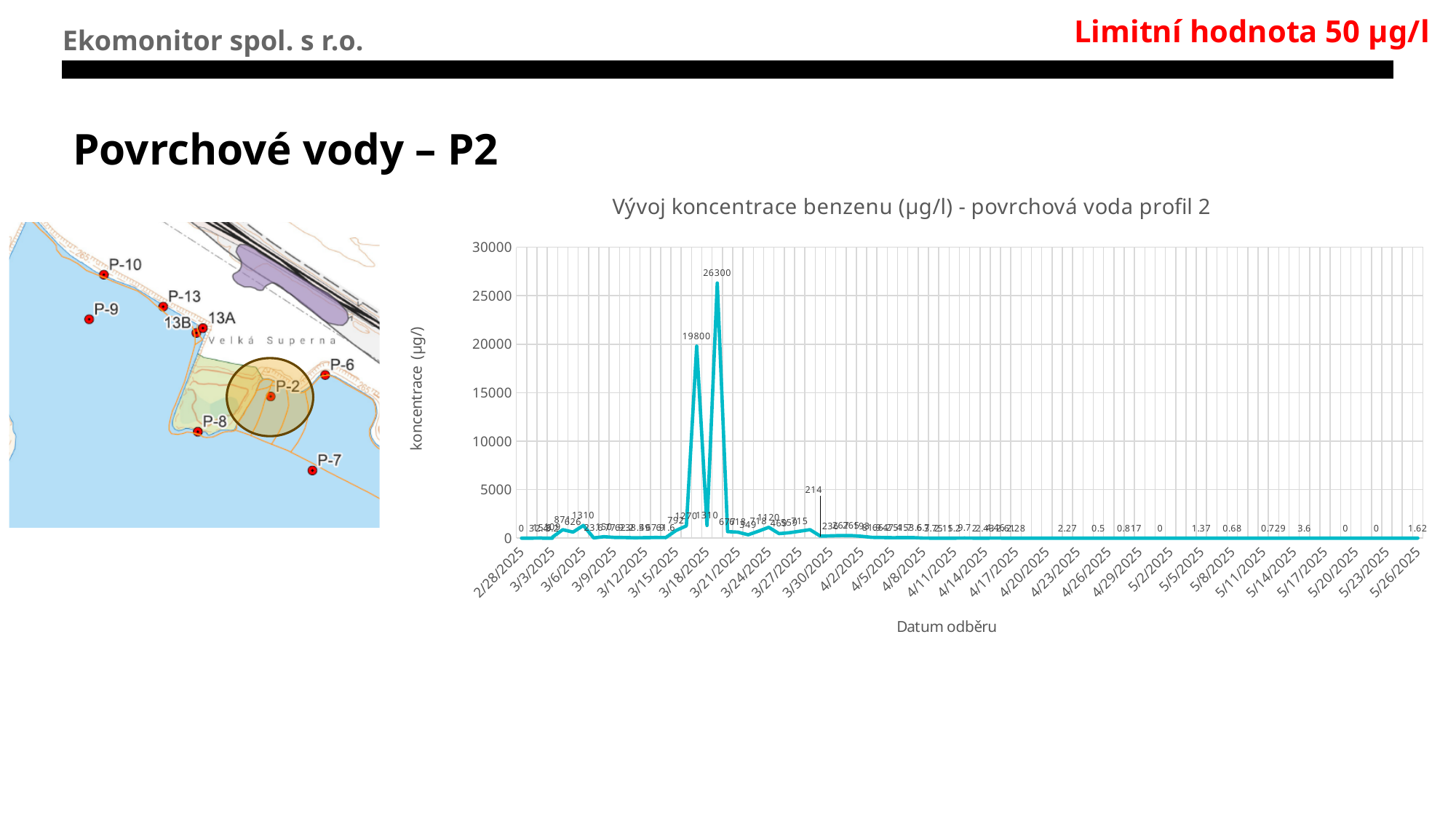
What is the title of the chart? Vývoj koncentrace benzenu (µg/l) - povrchová voda profil 2 What is the difference between the two highest labeled peaks, 26300 and 19800? 6500 Is the value for 5/26/2025 greater or less than 5000? less What is the label of the vertical axis of the chart? koncentrace (µg/l) What is the highest benzene concentration value labeled on the chart? 26300 Is the highest value on the chart greater or less than 25000? greater What is the second-highest peak value labeled on the chart? 19800 Which is larger, the peak labeled 26300 or the peak labeled 19800? 26300 What is the benzene concentration value labeled for the last date, 5/26/2025? 1.62 After the peaks in mid-March, do the values rise or fall toward the end of May? fall What kind of chart is shown on the slide? line chart What is the benzene concentration value labeled for the first date, 2/28/2025? 0